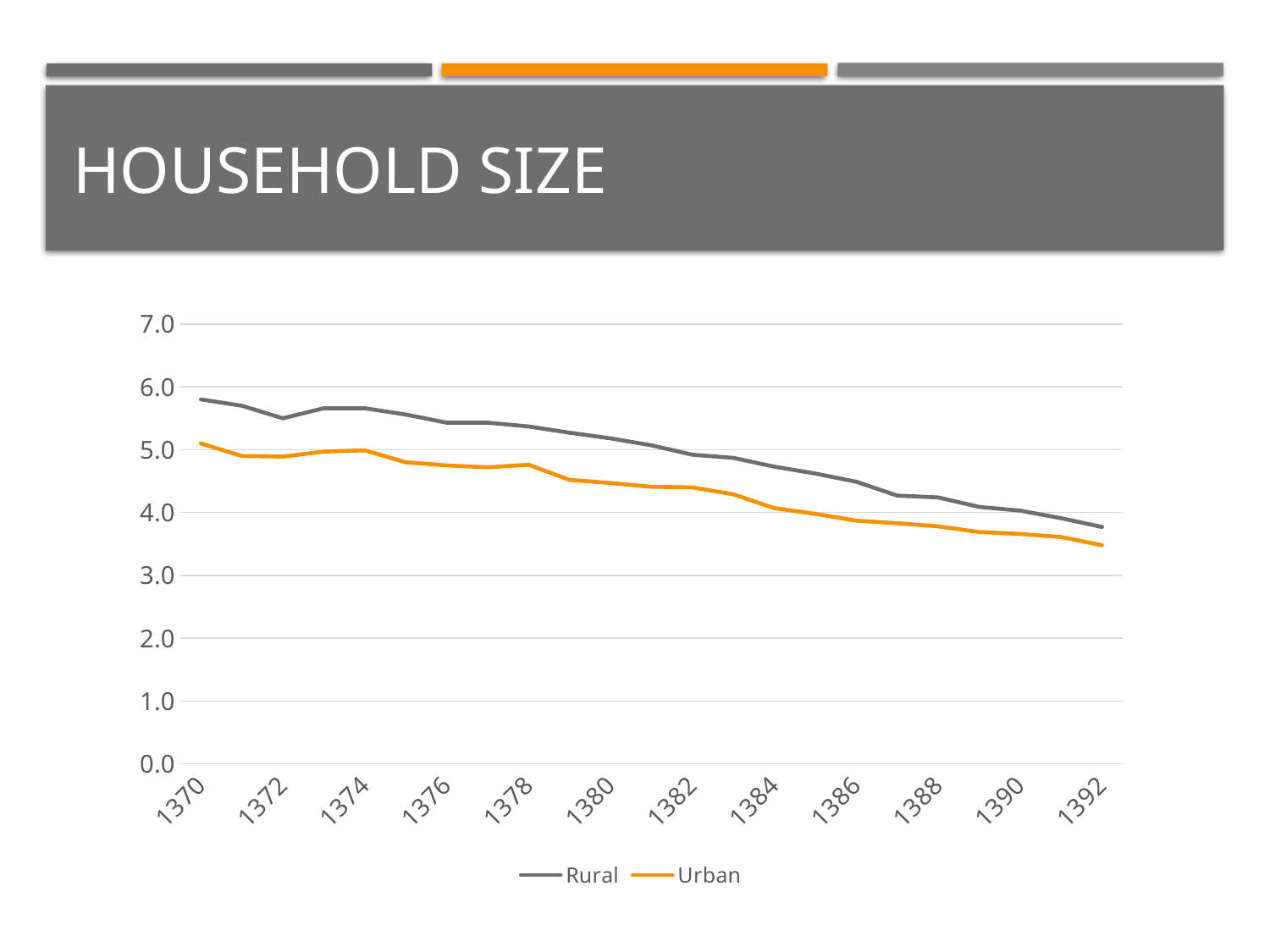
What is the title of the slide? HOUSEHOLD SIZE Is the Urban value at 1392 greater or less than 4.0? less How many series does the legend list? 2 Is the Rural value at 1370 greater or less than 5.0? greater Which colour is used for the Urban series? orange Which series has the higher value at 1380, Rural or Urban? Rural Is the Urban value at 1380 greater or less than 4.0? greater Do the Urban values rise or fall from 1370 to 1392? fall What kind of chart is shown on the slide? line chart Do the Rural values rise or fall from 1370 to 1392? fall How many year labels are shown on the x axis? 12 In which year is the Rural value lowest? 1392